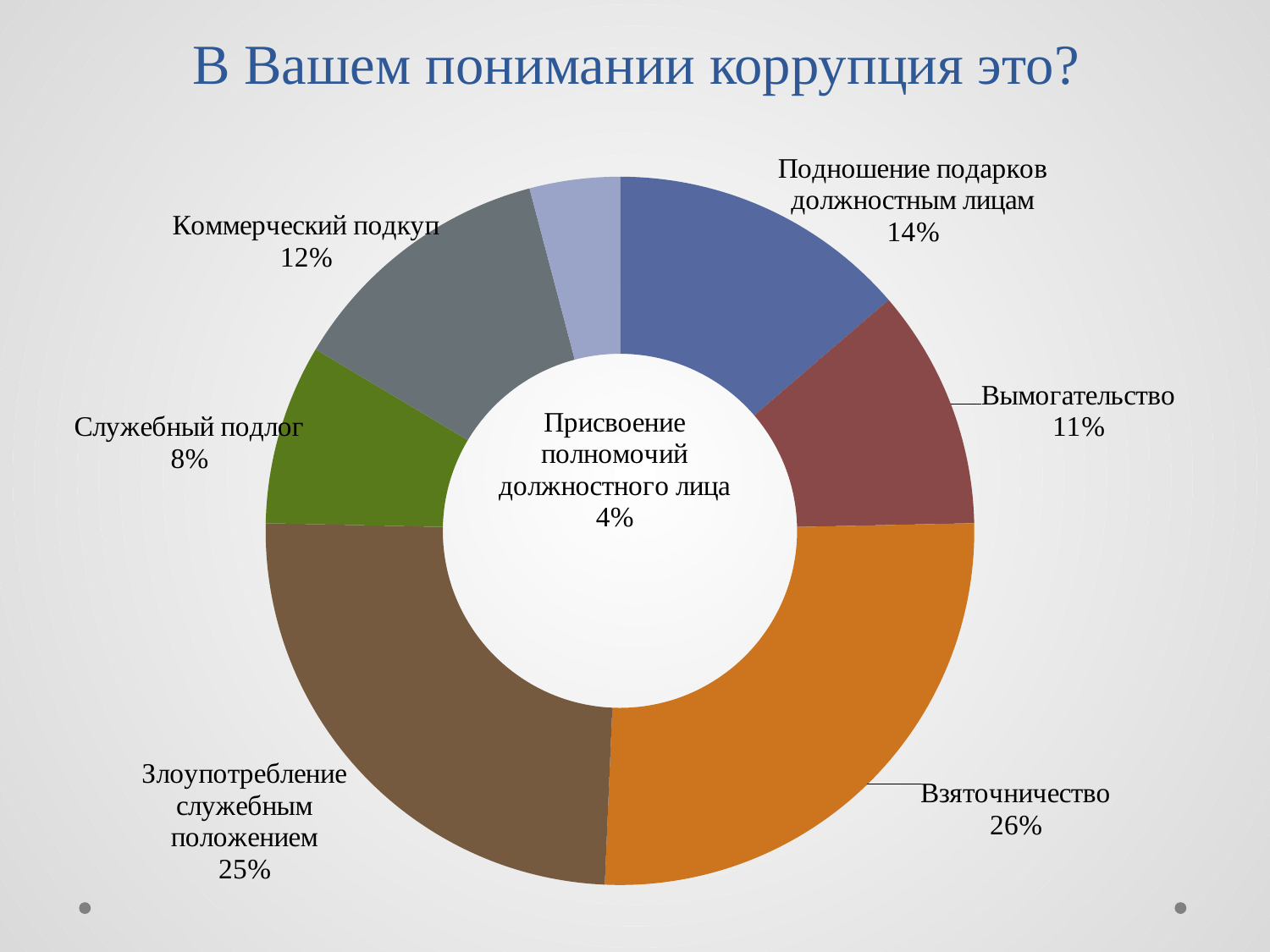
Which category has the smallest share in the chart? Присвоение полномочий должностного лица What percentage is shown for Вымогательство? 11% What percentage of respondents chose Взяточничество? 26% What is the title of the slide? В Вашем понимании коррупция это? Which has a larger share: Коммерческий подкуп or Вымогательство? Коммерческий подкуп What is the value shown for Служебный подлог? 8% Which category has the largest share in the chart? Взяточничество What is the difference between the shares for Взяточничество and Злоупотребление служебным положением? 1% What is the difference between the shares for Подношение подарков должностным лицам and Служебный подлог? 6% What type of chart is shown on the slide? Doughnut chart How many categories are shown in the chart? 7 Which has a larger share: Служебный подлог or Подношение подарков должностным лицам? Подношение подарков должностным лицам